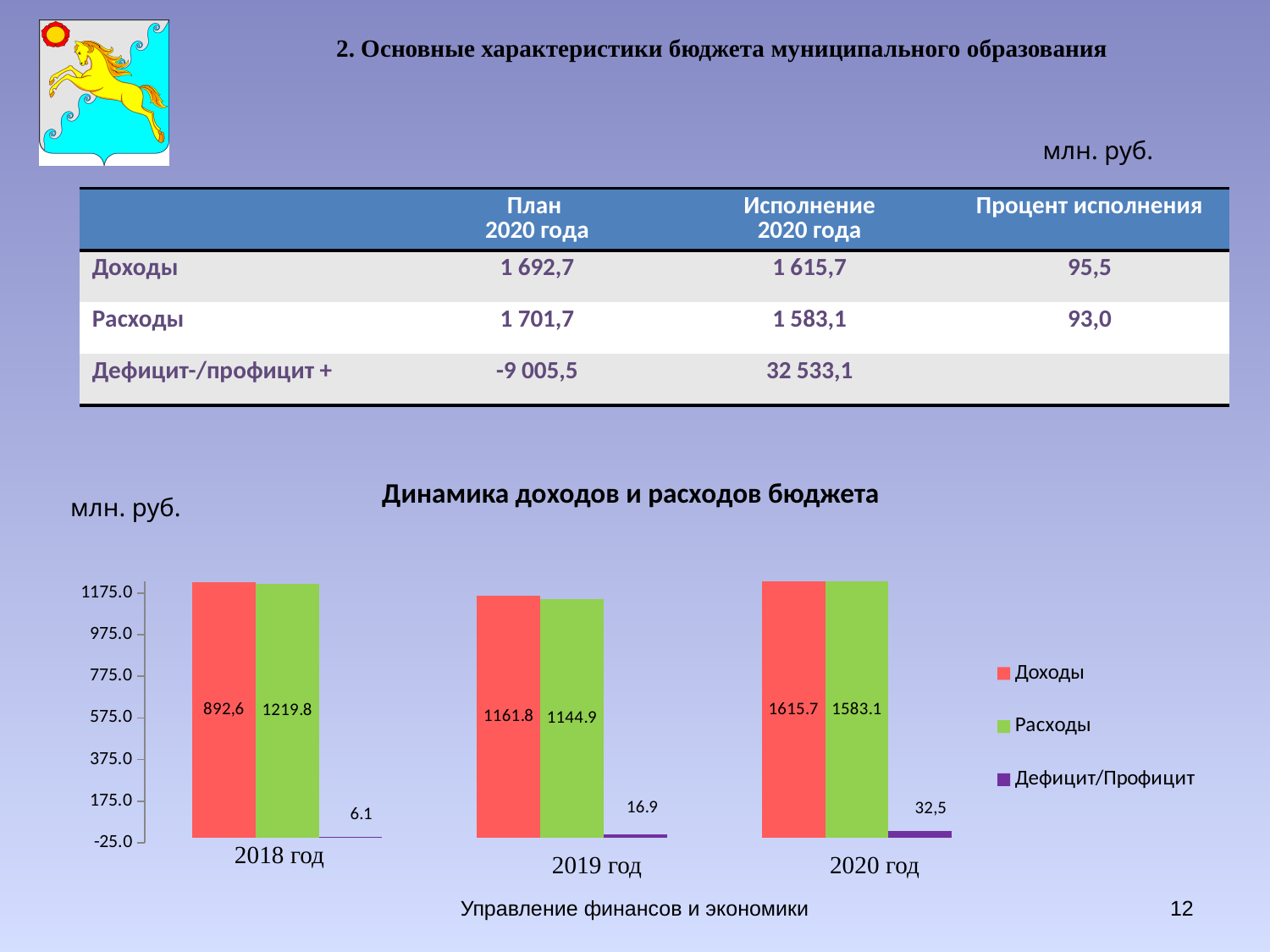
What is the value of Доходы for 2020 год in the chart? 1615.7 In which year is the Дефицит/Профицит value lowest in the chart? 2018 год Does the Дефицит/Профицит value rise or fall from 2018 год to 2020 год? rise What is the value of Расходы for 2019 год in the chart? 1144.9 How many years are shown on the x axis of the chart? 3 How many series does the chart legend list? 3 Is the value of Доходы for 2020 год greater or less than 975.0? greater What is the value of Дефицит/Профицит for 2020 год in the chart? 32,5 What is the value of Доходы for 2018 год in the chart 'Динамика доходов и расходов бюджета'? 892,6 What kind of chart is 'Динамика доходов и расходов бюджета'? bar chart In which year is the Дефицит/Профицит value highest in the chart? 2020 год What is the difference between Доходы and Расходы for 2019 год in the chart? 16.9